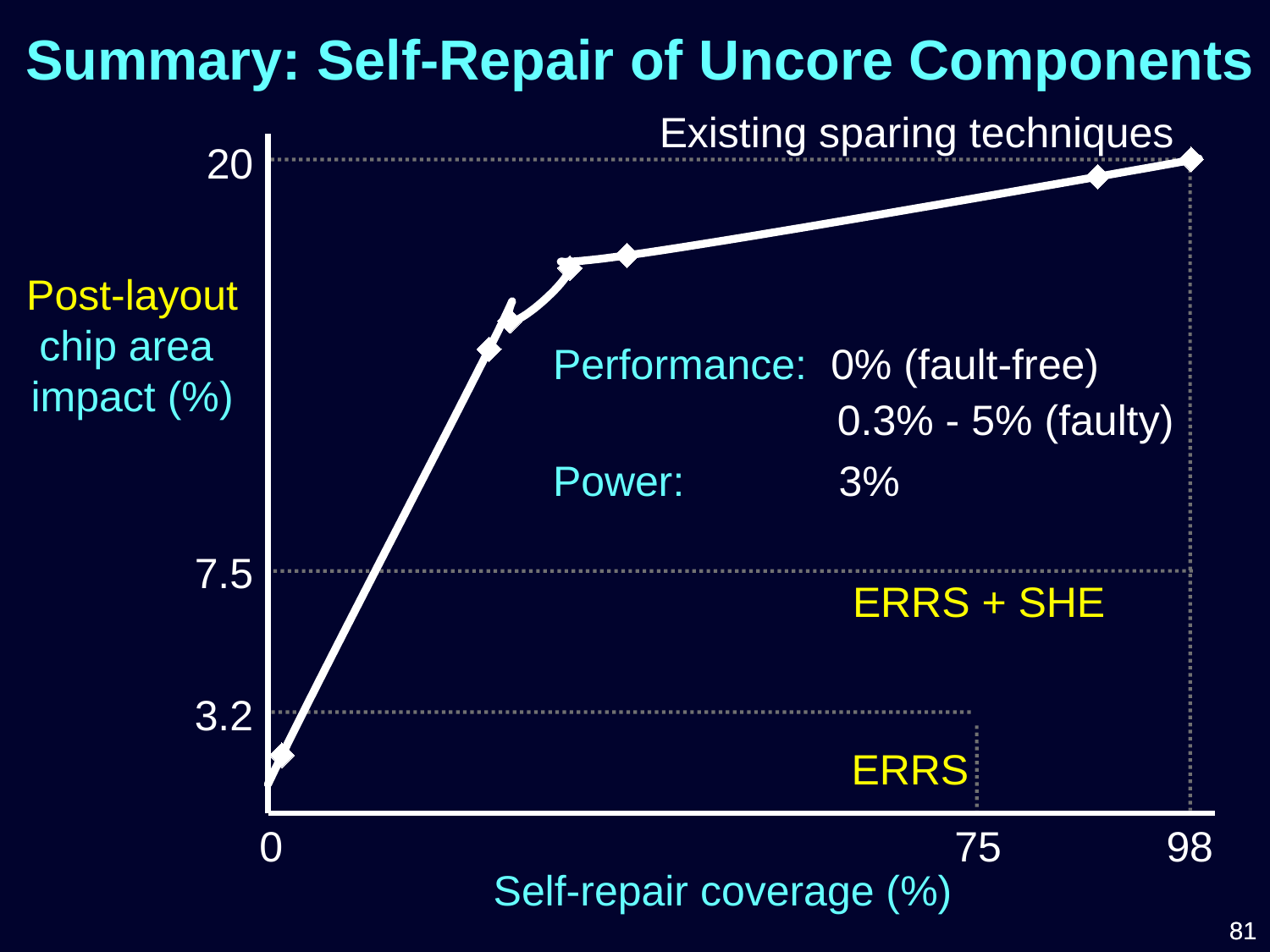
What is the label of the x axis? Self-repair coverage (%) Which has the higher post-layout chip area impact: 0% coverage or 98% coverage? 98% coverage Is the post-layout chip area impact at 75% self-repair coverage greater or less than 7.5? greater Is the post-layout chip area impact at 0% self-repair coverage greater or less than 3.2? less What kind of chart is shown on the slide? line chart What is the post-layout chip area impact at 98% self-repair coverage? 20 Does the post-layout chip area impact rise or fall as self-repair coverage increases along the x axis? rise What is the highest value labelled on the y axis? 20